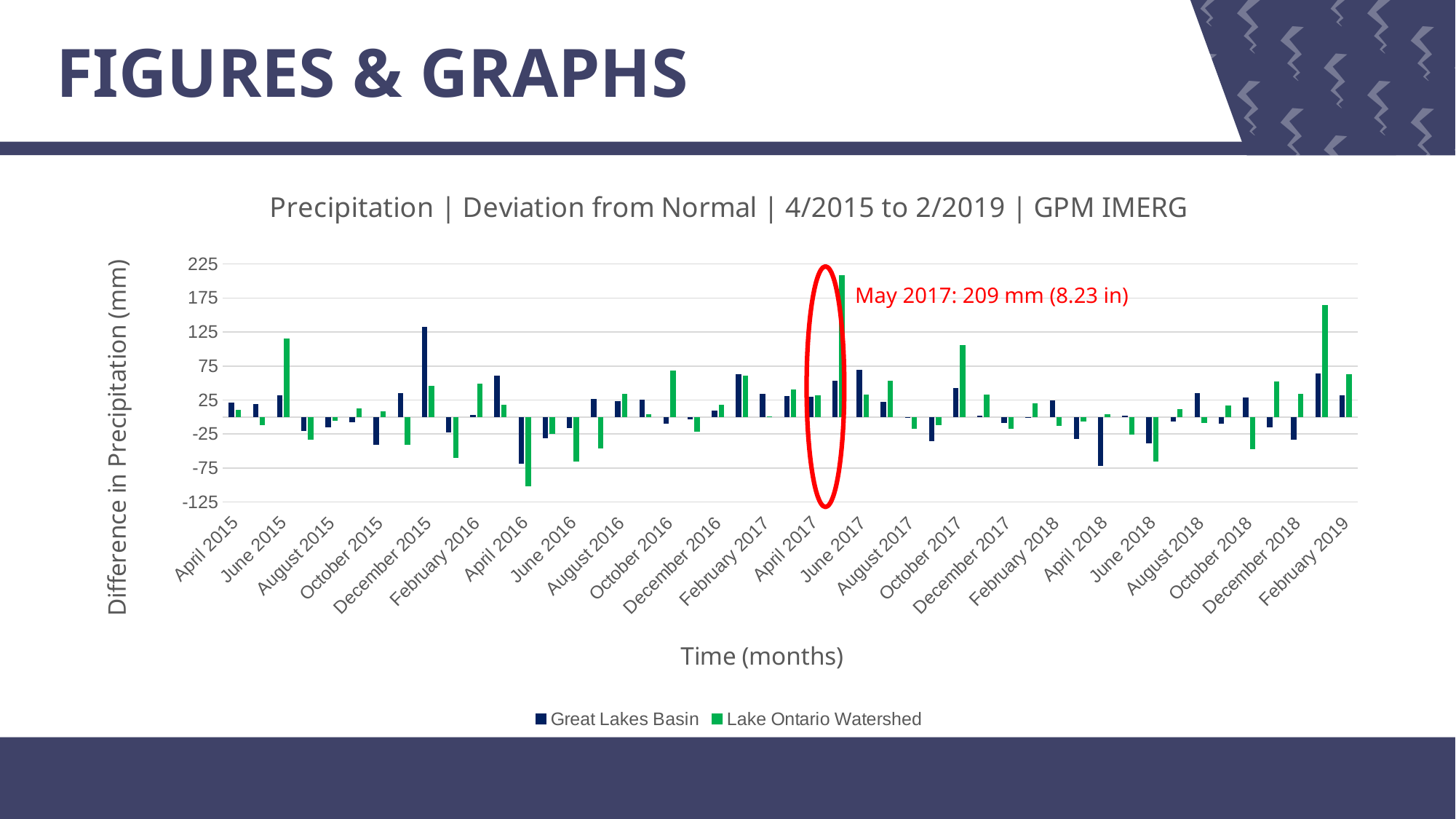
Is the Great Lakes Basin value for December 2015 greater or less than 75? greater Which series has the single highest bar on the chart? Lake Ontario Watershed Is the Lake Ontario Watershed value for April 2016 greater or less than -75? less What kind of chart is shown on the slide? bar chart According to the annotation, what is the May 2017 value in inches? 8.23 in How many month labels are shown along the x axis? 24 Is the Lake Ontario Watershed value for June 2015 greater or less than 75? greater In May 2017, which series has the larger value, Great Lakes Basin or Lake Ontario Watershed? Lake Ontario Watershed How many series does the legend list? 2 What is the annotated Lake Ontario Watershed precipitation deviation for May 2017? 209 mm What is the title of the y axis? Difference in Precipitation (mm)